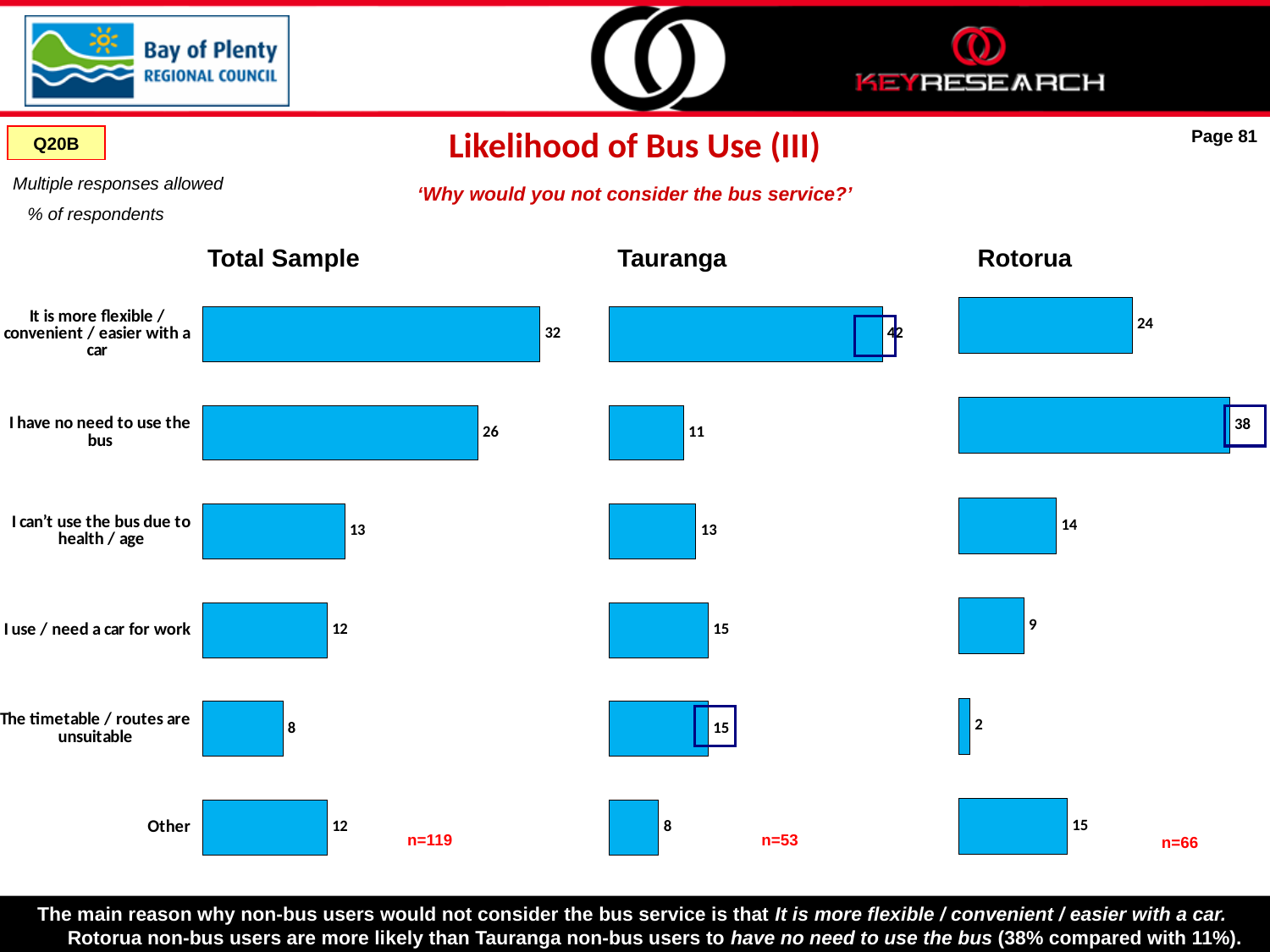
Which is larger: the Tauranga value for 'I use / need a car for work' or the Rotorua value for 'I use / need a car for work'? Tauranga What is the difference between the Rotorua and Tauranga values for 'I have no need to use the bus'? 27 In the Total Sample chart, what is the difference between 'It is more flexible / convenient / easier with a car' and 'I have no need to use the bus'? 6 In the Tauranga chart, which category has the lowest value? Other What type of chart is used for the Tauranga data? Bar chart In the Total Sample chart, which category has the lowest value? The timetable / routes are unsuitable What is the sample size (n) shown for the Rotorua chart? n=66 In the Rotorua chart, what is the value for 'The timetable / routes are unsuitable'? 2 How many categories are shown in the Total Sample chart? 6 In the Total Sample chart, what is the value for 'I have no need to use the bus'? 26 In the Rotorua chart, which category has the highest value? I have no need to use the bus In the Tauranga chart, what is the value for 'It is more flexible / convenient / easier with a car'? 42